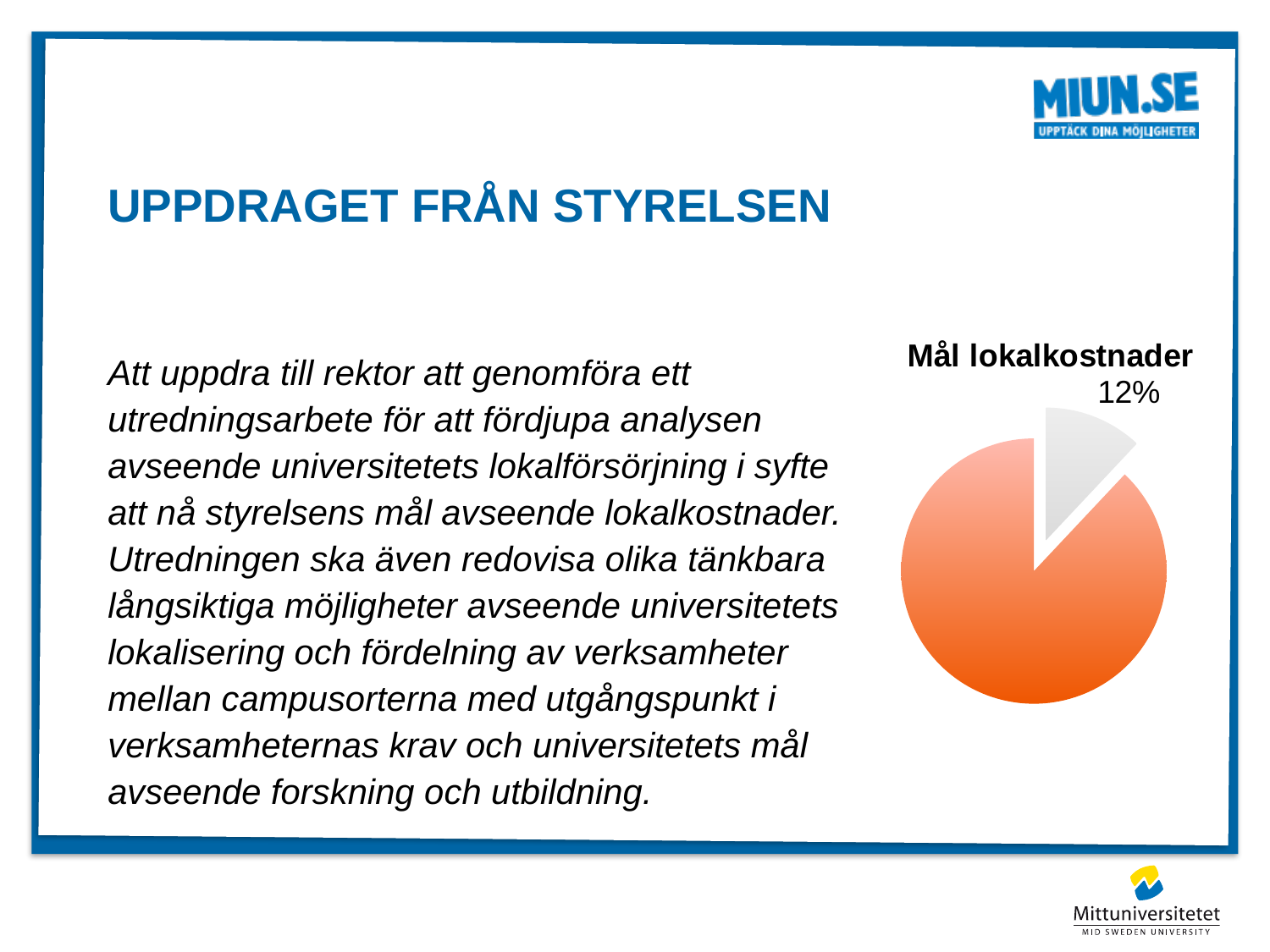
How many slices does the pie chart have? 2 What kind of chart is shown on the slide? pie chart What percentage is printed on the labelled slice of the pie chart? 12% What colour is the slice labelled 12% in the pie chart? grey Which slice of the pie chart is the smallest? the grey slice labelled 12% What is the title of the chart on the slide? Mål lokalkostnader Which slice of the pie chart is larger, the orange slice or the grey slice? the orange slice